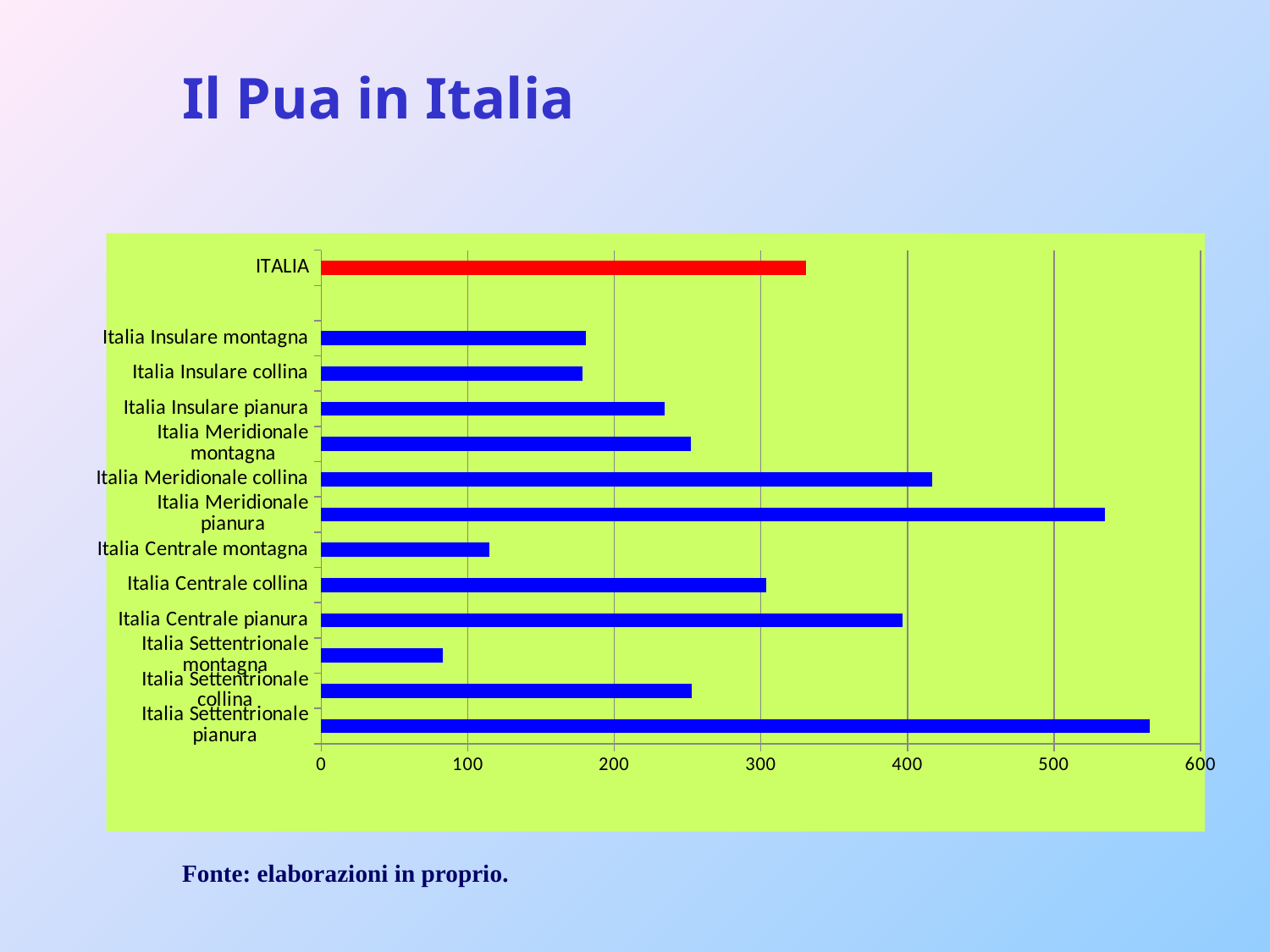
What colour is the bar for ITALIA? red Which category has the highest value? Italia Settentrionale pianura Is the value for Italia Settentrionale montagna greater or less than 100? less Is the value for Italia Insulare pianura greater or less than 200? greater What kind of chart is shown on the slide? bar chart Which category has the lowest value? Italia Settentrionale montagna Is the value for Italia Centrale montagna greater or less than 100? greater How many categories are plotted on the chart? 13 Which is larger, the value for Italia Meridionale collina or the value for Italia Centrale pianura? Italia Meridionale collina